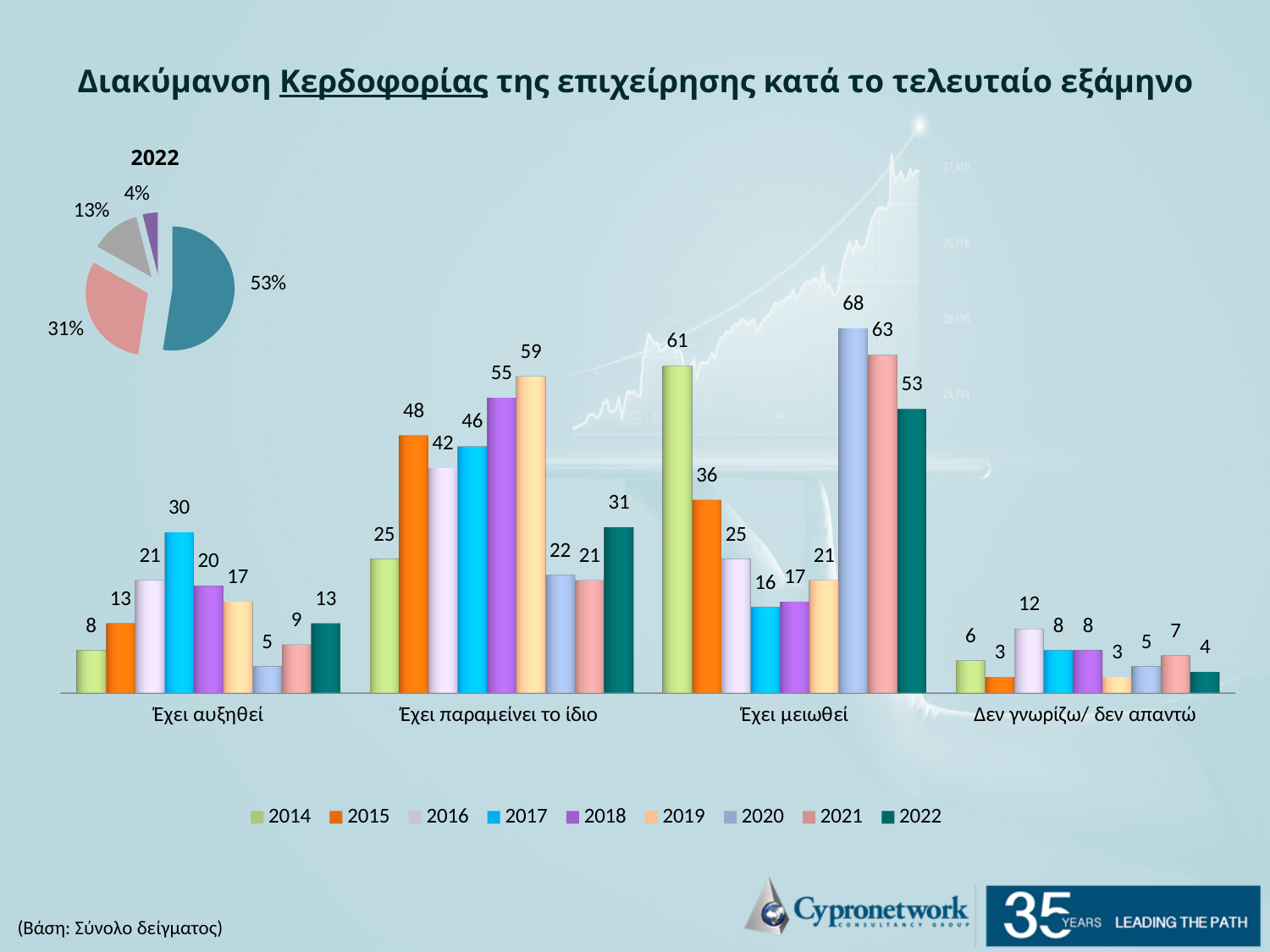
In the bar chart, what is the value for 2017 in the 'Έχει αυξηθεί' category? 30 In the bar chart, which year has the lowest value in the 'Έχει αυξηθεί' category? 2020 In the bar chart, what is the value for 2019 in the 'Έχει παραμείνει το ίδιο' category? 59 In the 2022 pie chart, what is the share of the smallest slice? 4% In the bar chart, what is the difference between the 2020 and 2022 values in the 'Έχει μειωθεί' category? 15 In the bar chart, which year has the highest value in the 'Έχει μειωθεί' category? 2020 In the bar chart, which is larger in the 'Έχει παραμείνει το ίδιο' category: the value for 2015 or the value for 2016? 2015 How many categories are shown on the x axis of the bar chart? 4 In the bar chart, what is the value for 2022 in the 'Έχει μειωθεί' category? 53 In the 2022 pie chart, what is the share of the largest slice? 53% How many series does the legend of the bar chart list? 9 What kind of chart is the large chart at the bottom of the slide? Bar chart